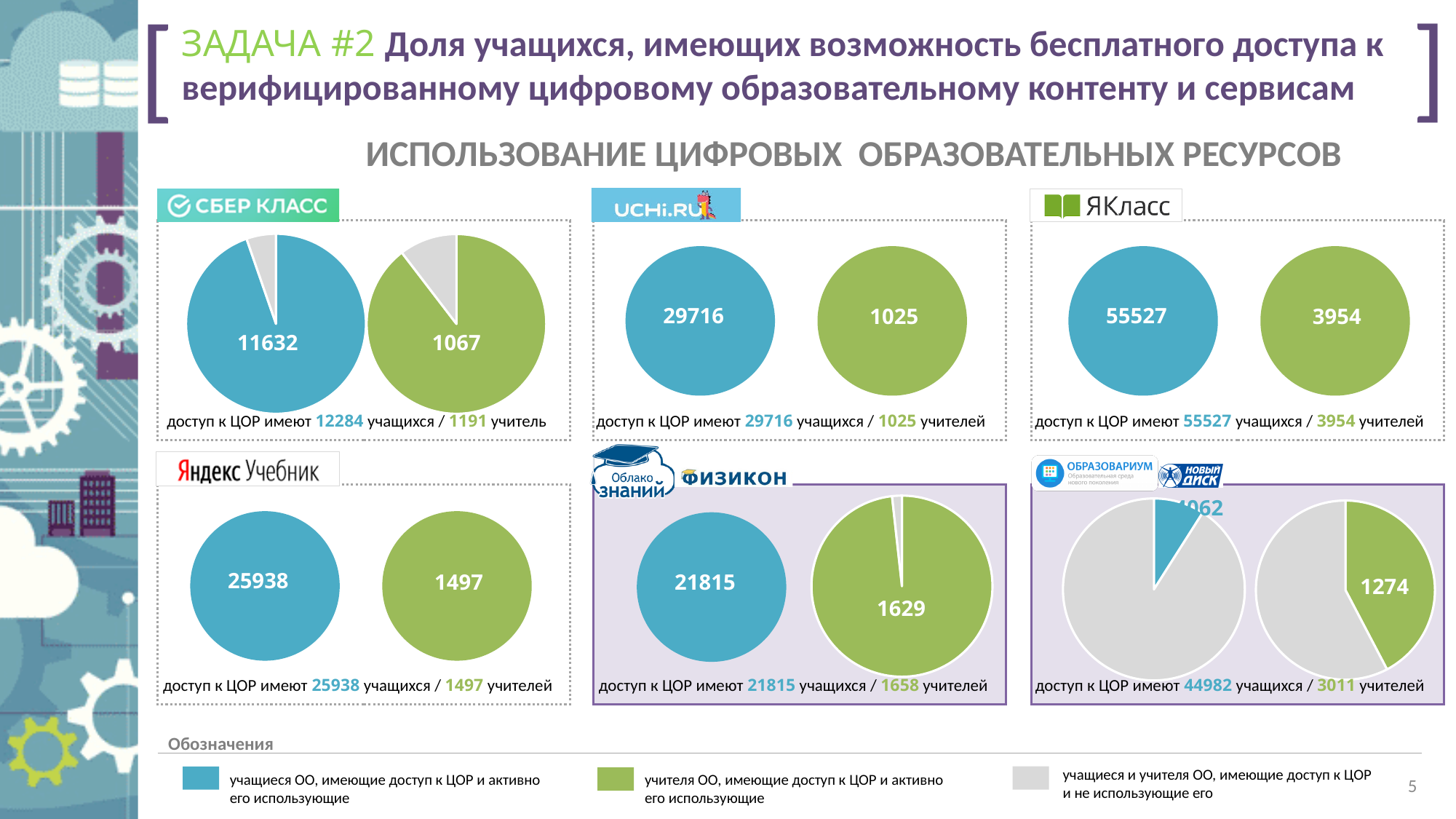
Across the six platforms, which one has the lowest printed number of teachers actively using the resource? UCHi.RU Which is larger: the number of active students on UCHi.RU or on Яндекс Учебник? UCHi.RU What type of chart is used for each platform on this slide? Pie chart Across the six platforms, which one has the highest printed number of students actively using the resource? ЯКласс In the UCHi.RU chart, what value is printed on the blue pie for students? 29716 In the ЯКласс chart, what value is printed on the green pie for teachers? 3954 In the Яндекс Учебник chart, what value is printed on the blue pie for students? 25938 In the СБЕР КЛАСС chart, what value is printed on the green pie for teachers actively using the resource? 1067 In the СБЕР КЛАСС chart, what value is printed on the blue pie for students actively using the resource? 11632 In the Образовариум / Новый диск chart, what value is printed on the green pie for teachers actively using the resource? 1274 In the СБЕР КЛАСС chart, how many students have access but do not actively use the resource (12284 with access minus 11632 active)? 652 In the Облако знаний / Физикон chart, what value is printed on the green pie for teachers? 1629